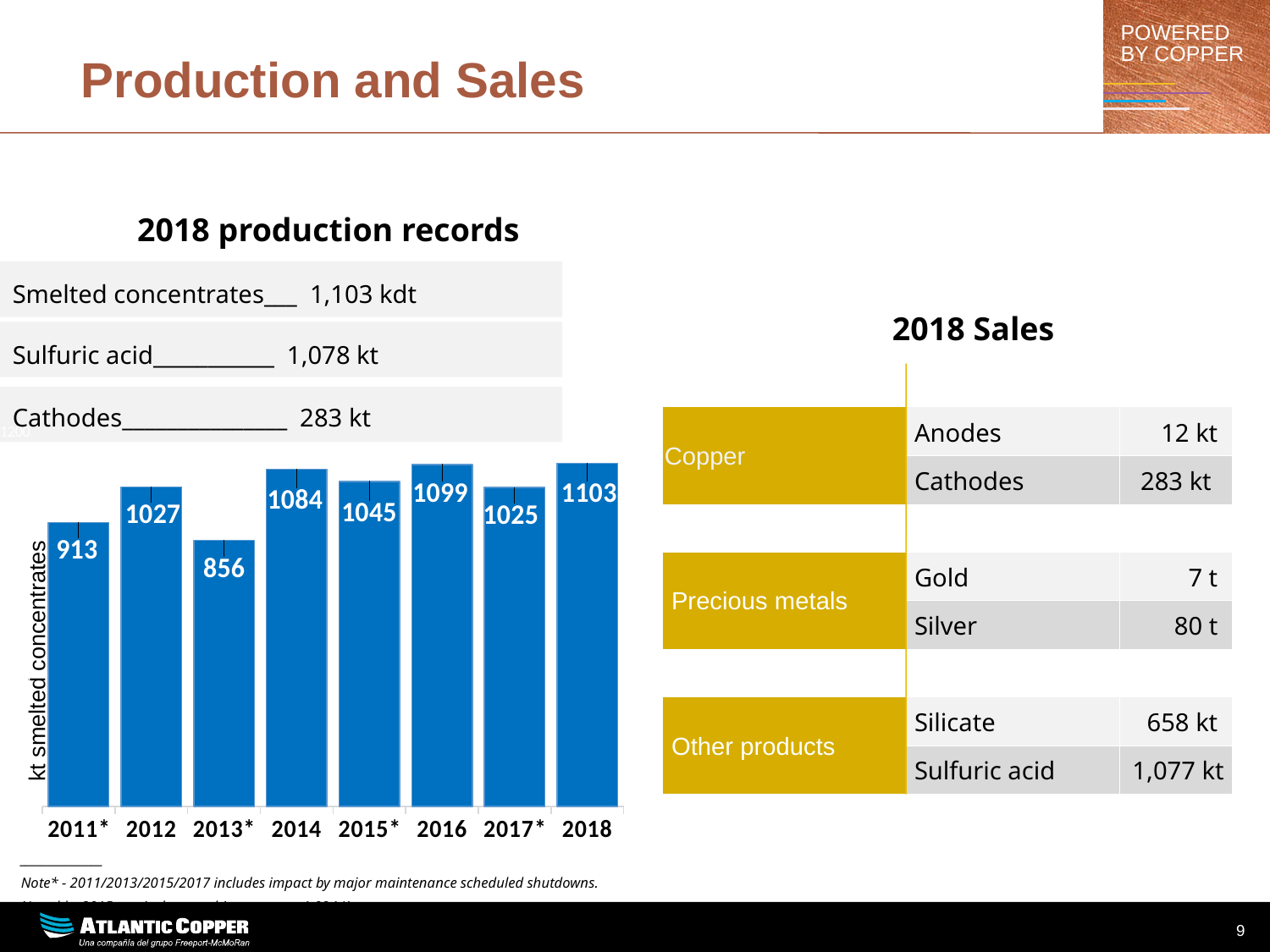
Which year has a larger value of kt smelted concentrates, 2011* or 2017*? 2017* Which year has the lowest value of kt smelted concentrates? 2013* What type of chart is used to show kt smelted concentrates by year? Bar chart Which year has a larger value of kt smelted concentrates, 2012 or 2015*? 2015* What is the value of kt smelted concentrates for 2013*? 856 What is the value of kt smelted concentrates for 2016? 1099 What is the difference in kt smelted concentrates between 2014 and 2011*? 171 Which year has the highest value of kt smelted concentrates? 2018 What is the difference in kt smelted concentrates between 2018 and 2013*? 247 How many years are shown in the bar chart? 8 What is the value of kt smelted concentrates for 2018? 1103 What is the label of the vertical axis of the bar chart? kt smelted concentrates